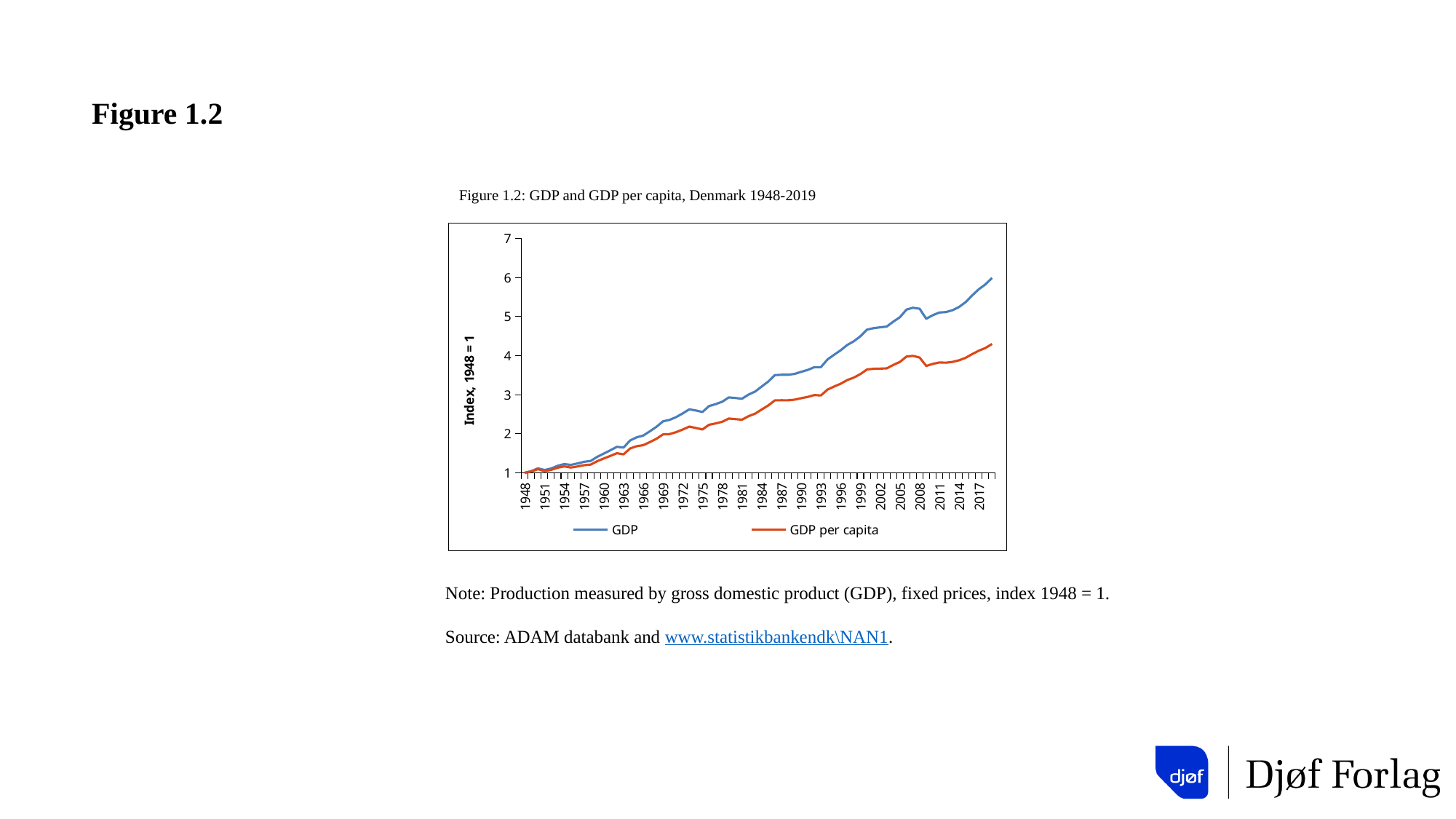
What kind of chart is shown in Figure 1.2? line chart What is the index value of GDP per capita in 1948? 1 Is the value for GDP in 2017 greater or less than 5? greater Is the value for GDP per capita in 1984 greater or less than 2? greater What is the index value of GDP in 1948? 1 Is the value for GDP in 1969 greater or less than 2? greater What is the label on the vertical axis of the chart? Index, 1948 = 1 In 2017, which series has the higher value, GDP or GDP per capita? GDP Does the GDP series generally rise or fall from 1948 to 2019? rise How many series does the legend of the chart list? 2